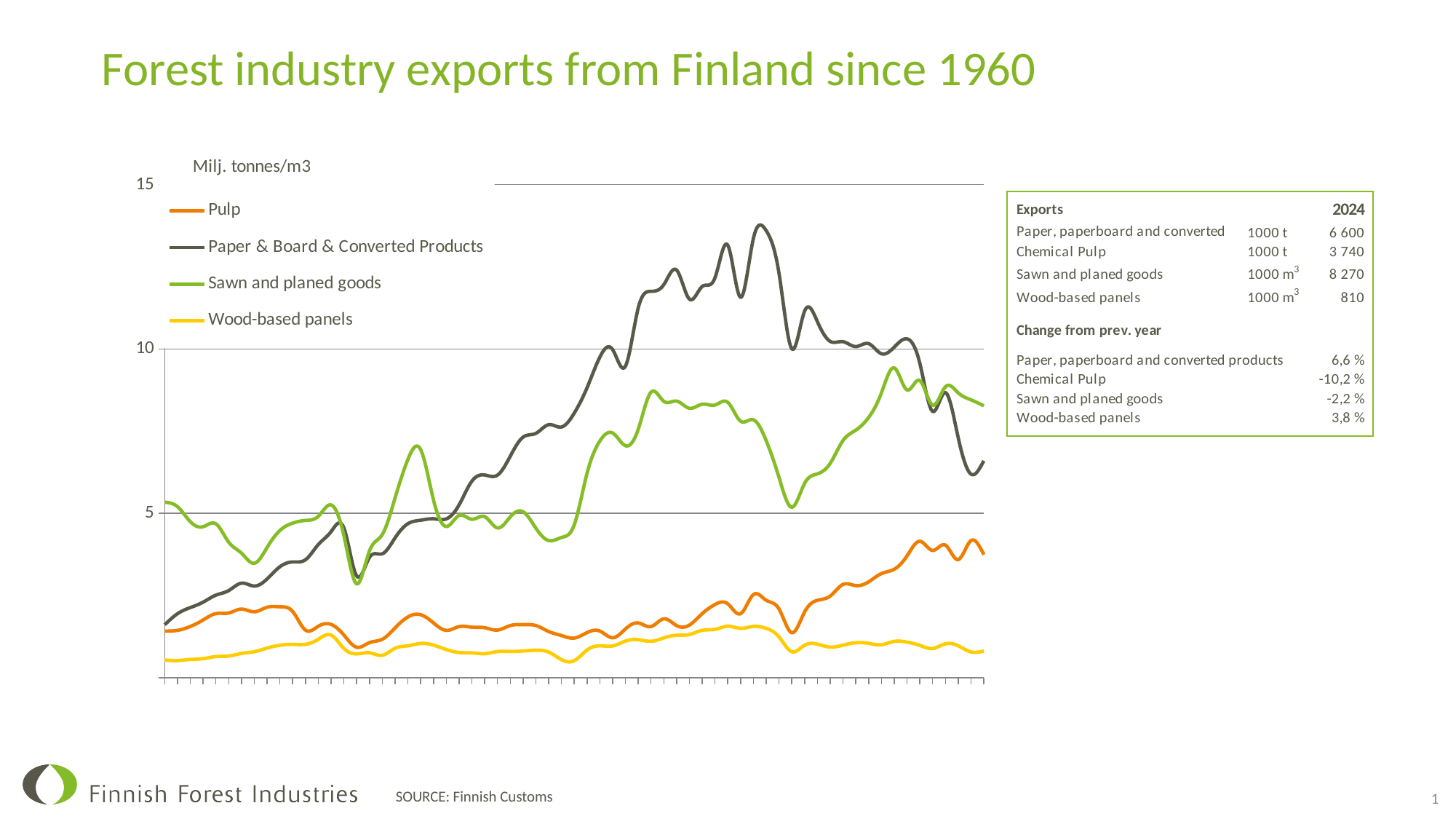
At the right end of the chart, which is higher: Sawn and planed goods or Paper & Board & Converted Products? Sawn and planed goods Which series reaches the highest value anywhere on the chart? Paper & Board & Converted Products At the right end of the chart, is the value for Sawn and planed goods greater or less than 5? greater How many series does the chart's legend list? 4 What unit is shown above the y axis of the chart? Milj. tonnes/m3 Is the peak value of the Paper & Board & Converted Products line greater or less than 10? greater Which series stays lowest across the whole chart? Wood-based panels What kind of chart is shown on the slide? Line chart At the right end of the chart, is the value for Pulp greater or less than 5? less Does the Pulp line overall rise or fall from the left end of the chart to the right end? rise What is the highest value labelled on the y axis of the chart? 15 At the right end of the chart, which is higher: Pulp or Wood-based panels? Pulp